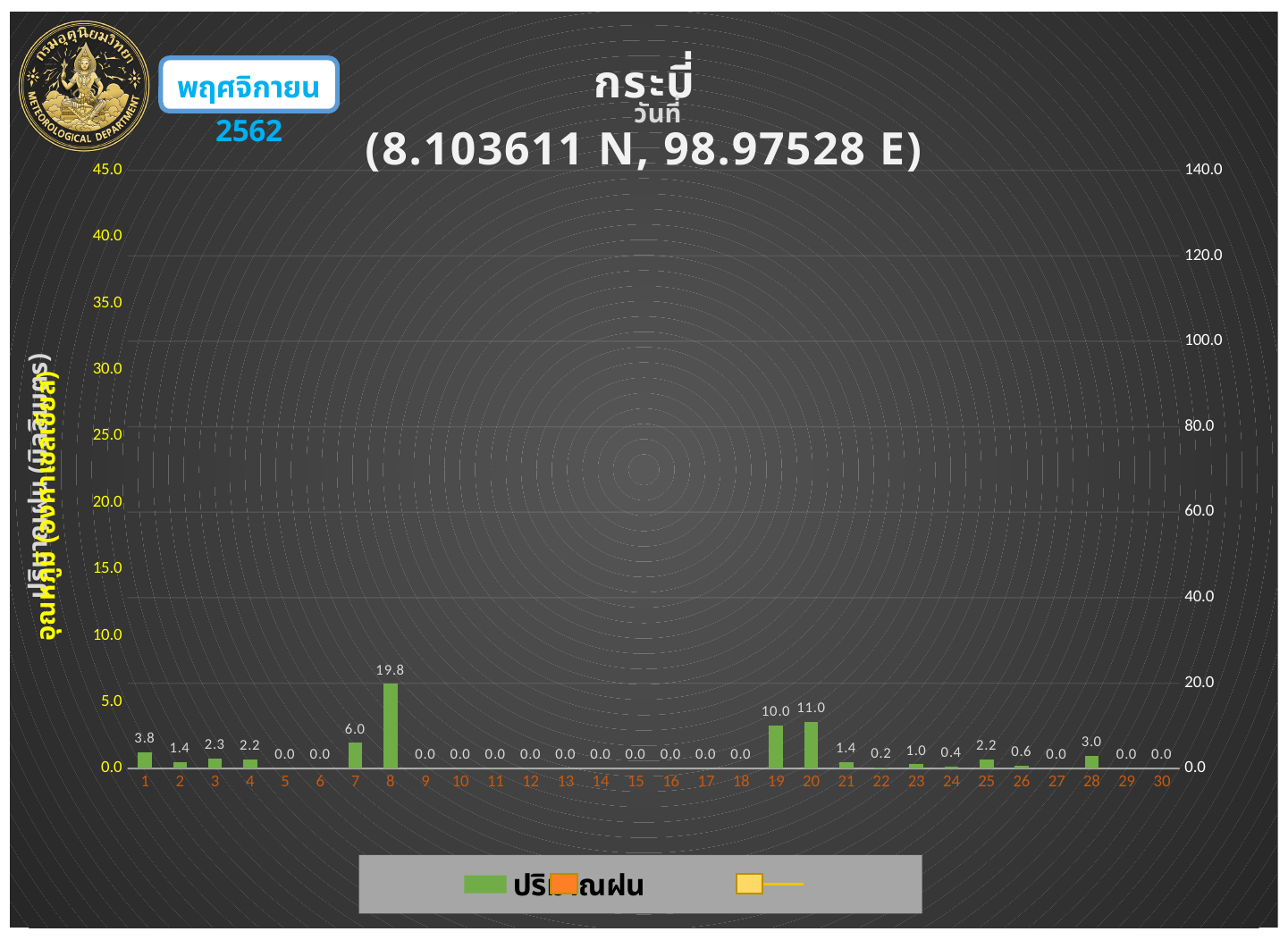
What kind of chart is shown on the slide? bar chart What is the difference between the values for day 8 and day 20? 8.8 Which is larger, the value for day 7 or the value for day 1? day 7 What is the value for day 1? 3.8 What is the difference between the values for day 20 and day 19? 1.0 How many days are shown on the x axis? 30 What is the value for day 8? 19.8 What is the value for day 20? 11.0 Which day has the highest value? 8 What coordinates are given in the chart title? 8.103611 N, 98.97528 E What is the value for day 19? 10.0 What is the value for day 28? 3.0